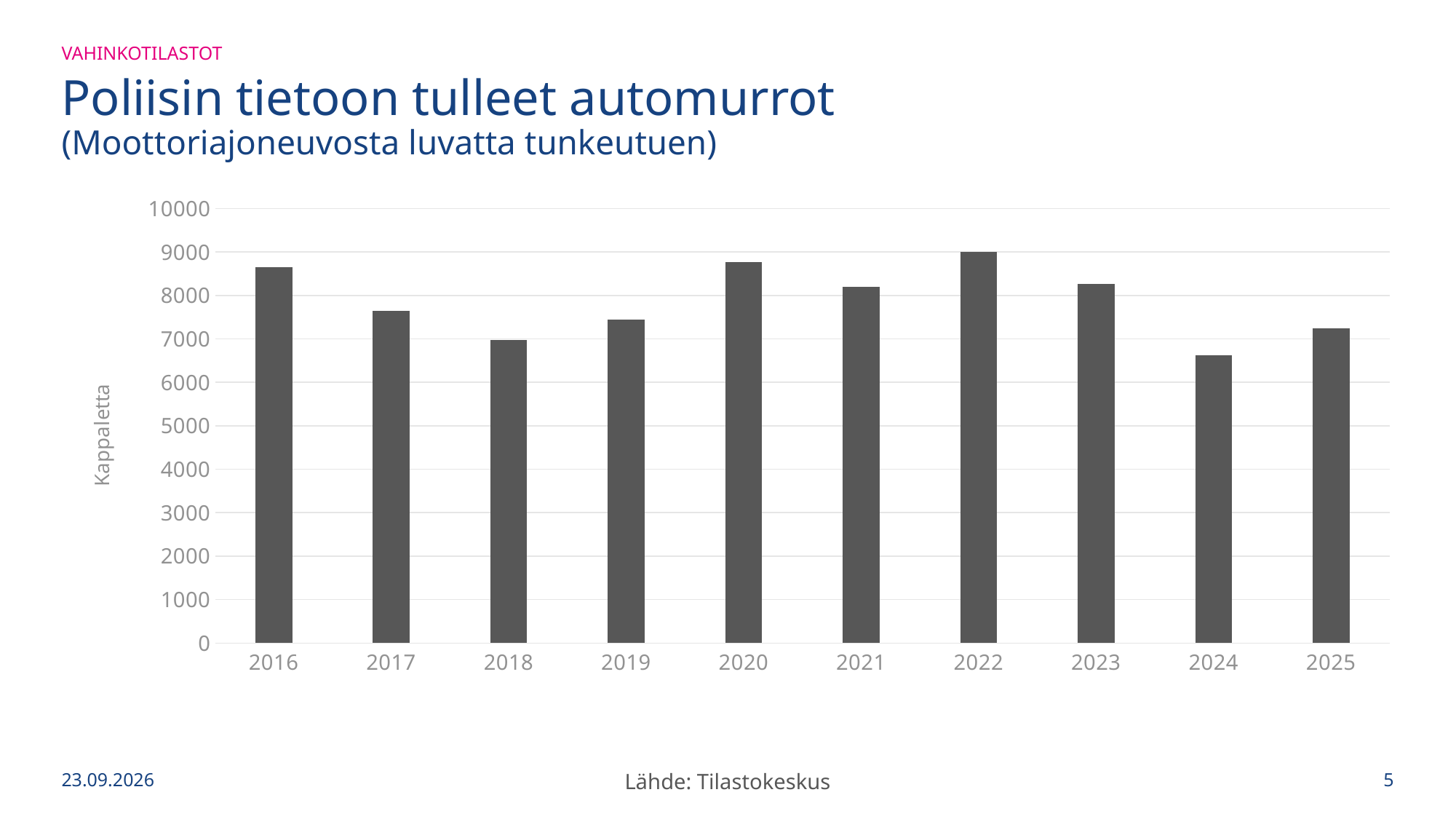
What is the main title of the chart on the slide? Poliisin tietoon tulleet automurrot Which year has the highest number of reported car break-ins? 2022 What kind of chart is shown on the slide? bar chart Which year has the larger value, 2016 or 2017? 2016 How many years are shown on the x axis of the chart? 10 Is the value for 2017 greater or less than 8000? less Is the value for 2016 greater or less than 8000? greater Which year has the lowest number of reported car break-ins? 2024 Which year has the larger value, 2024 or 2025? 2025 Is the value for 2019 greater or less than 7000? greater What is the label on the vertical axis of the chart? Kappaletta